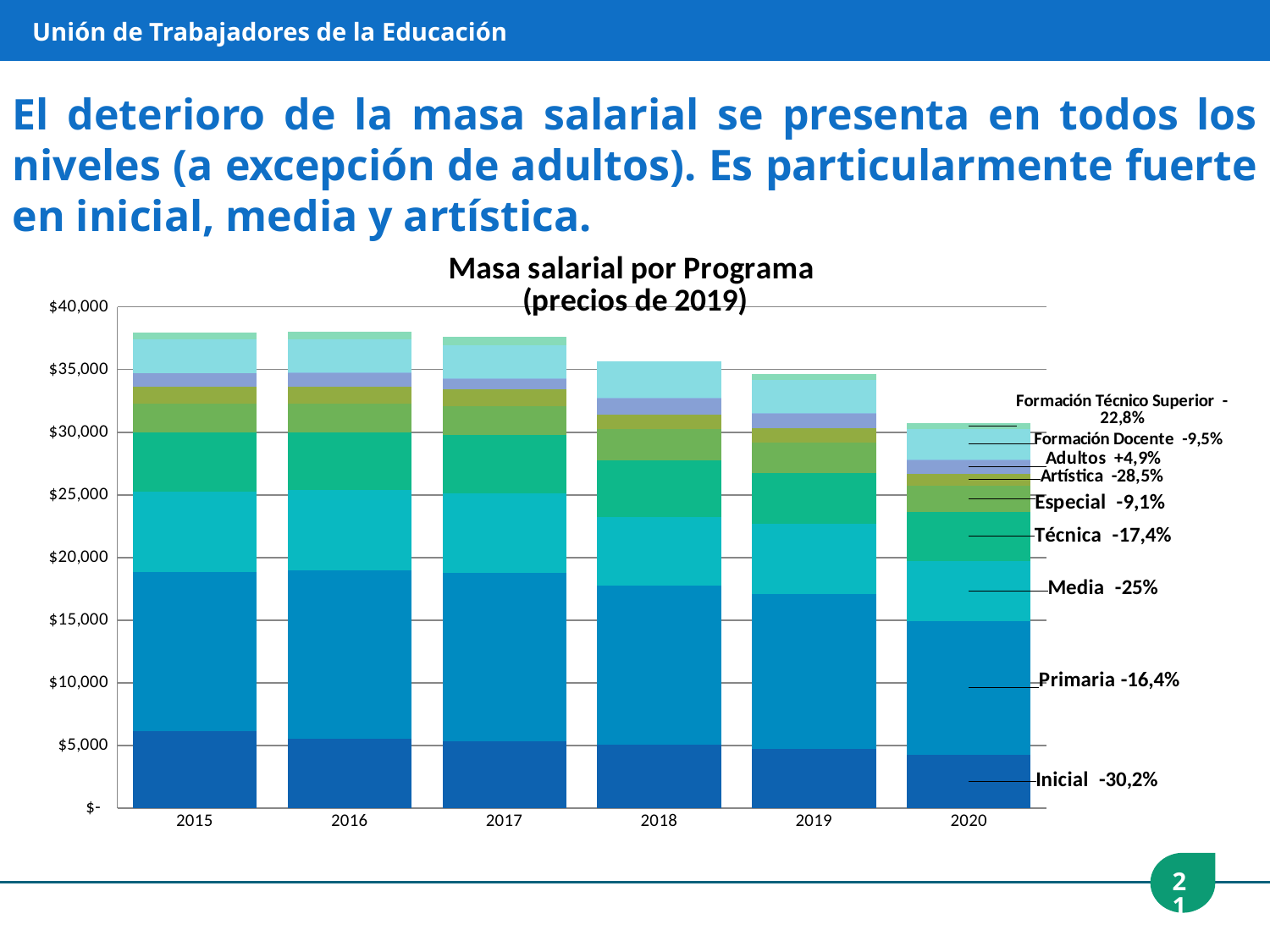
Is the total masa salarial for 2020 greater or less than $35,000? less How many programs (series) are labelled in the chart? 9 What kind of chart is shown on the slide? Stacked bar chart What is the title of the chart? Masa salarial por Programa (precios de 2019) Which program is the only one with a positive percentage change in the chart? Adultos (+4,9%) What percentage change is shown for the Inicial program? -30,2% What percentage change is shown for the Media program? -25% Does the total masa salarial rise or fall from 2015 to 2020? Fall Which is larger, the total masa salarial for 2015 or for 2020? 2015 How many years are shown on the x axis of the chart? 6 Which year has the lowest total masa salarial in the chart? 2020 Is the total masa salarial for 2015 greater or less than $35,000? greater